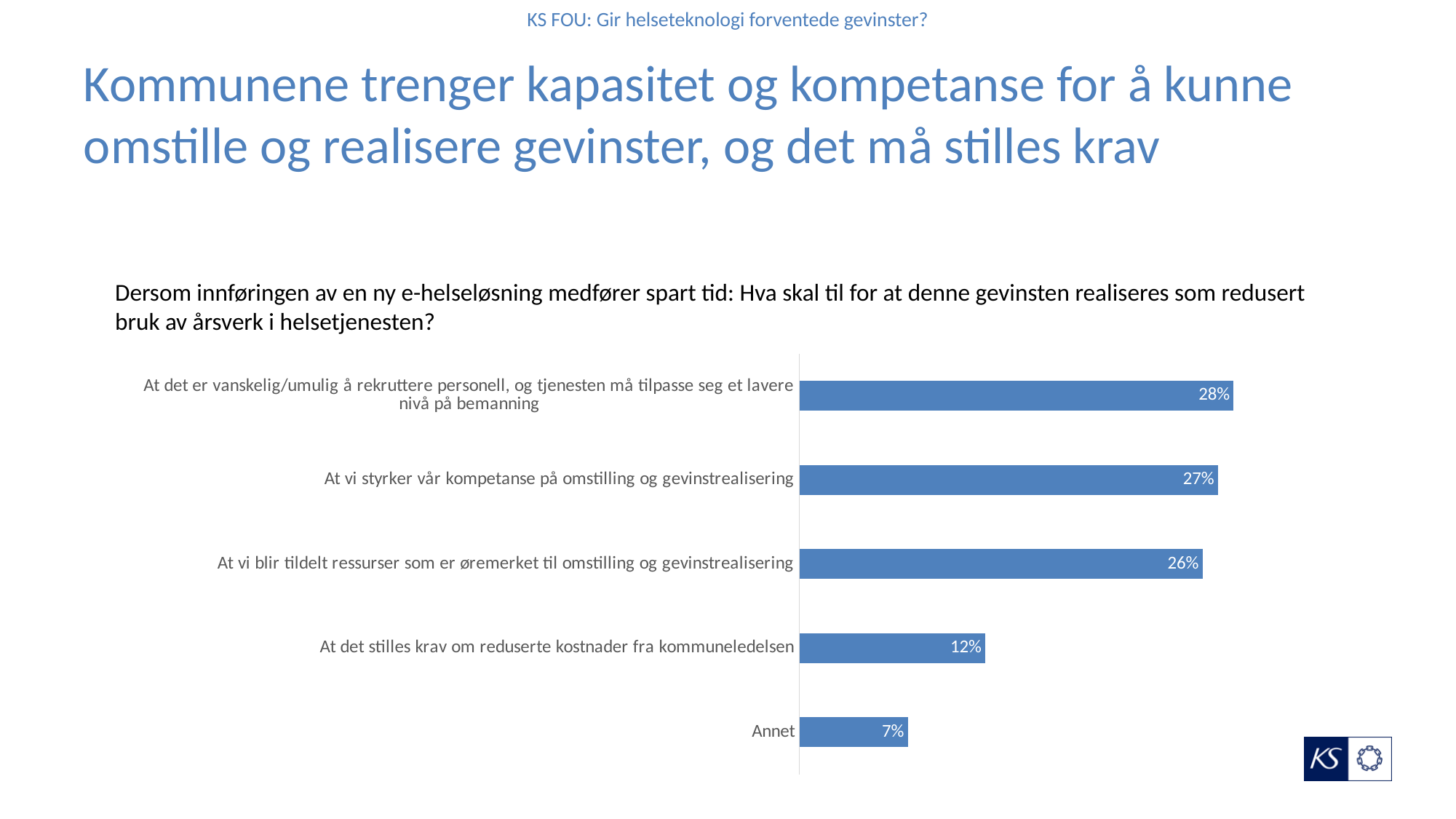
What is the difference between the values for "At det er vanskelig/umulig å rekruttere personell, og tjenesten må tilpasse seg et lavere nivå på bemanning" and "Annet"? 21% Which category has the highest value? At det er vanskelig/umulig å rekruttere personell, og tjenesten må tilpasse seg et lavere nivå på bemanning What is the value for "Annet"? 7% What kind of chart is shown on the slide? Bar chart What is the value for "At vi styrker vår kompetanse på omstilling og gevinstrealisering"? 27% What is the value for "At det stilles krav om reduserte kostnader fra kommuneledelsen"? 12% Which category has the lowest value? Annet What is the difference between the values for "At vi styrker vår kompetanse på omstilling og gevinstrealisering" and "At det stilles krav om reduserte kostnader fra kommuneledelsen"? 15% What is the value for "At vi blir tildelt ressurser som er øremerket til omstilling og gevinstrealisering"? 26% How many categories are shown in the chart? 5 Which is larger: the value for "At det stilles krav om reduserte kostnader fra kommuneledelsen" or the value for "Annet"? At det stilles krav om reduserte kostnader fra kommuneledelsen What colour are the bars in the chart? Blue